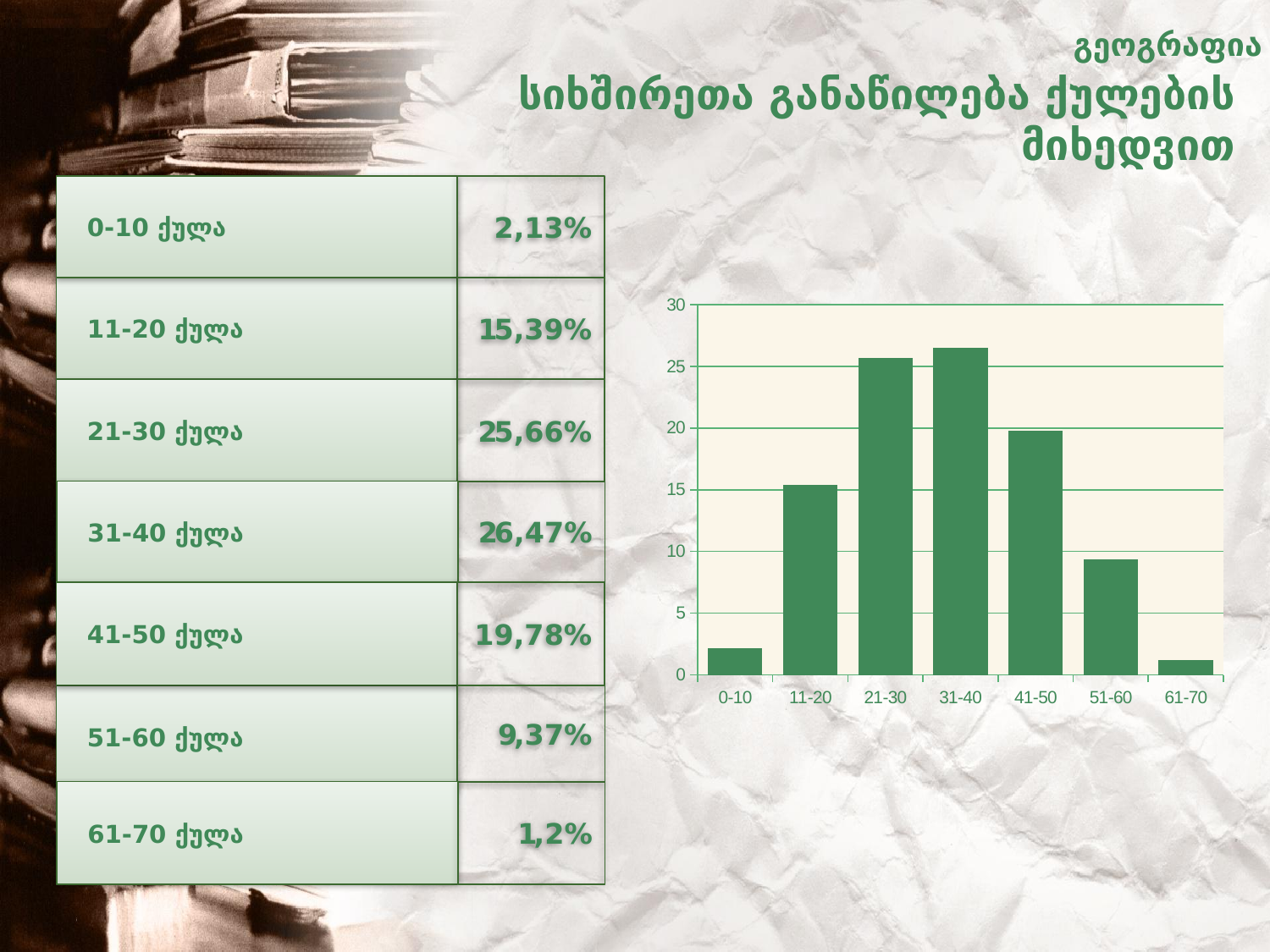
Do the bars rise or fall from 31-40 to 61-70 along the x axis? fall What is the highest tick value shown on the vertical axis of the chart? 30 Is the value for 21-30 greater or less than 25? greater Which category has the highest bar in the chart? 31-40 Is the value for 11-20 greater or less than 15? greater How many categories are shown on the x axis of the bar chart? 7 Which is larger, the bar for 0-10 or the bar for 61-70? 0-10 Is the value for 51-60 greater or less than 10? less What kind of chart is shown on the slide? bar chart Which category has the lowest bar in the chart? 61-70 Which is larger, the bar for 11-20 or the bar for 41-50? 41-50